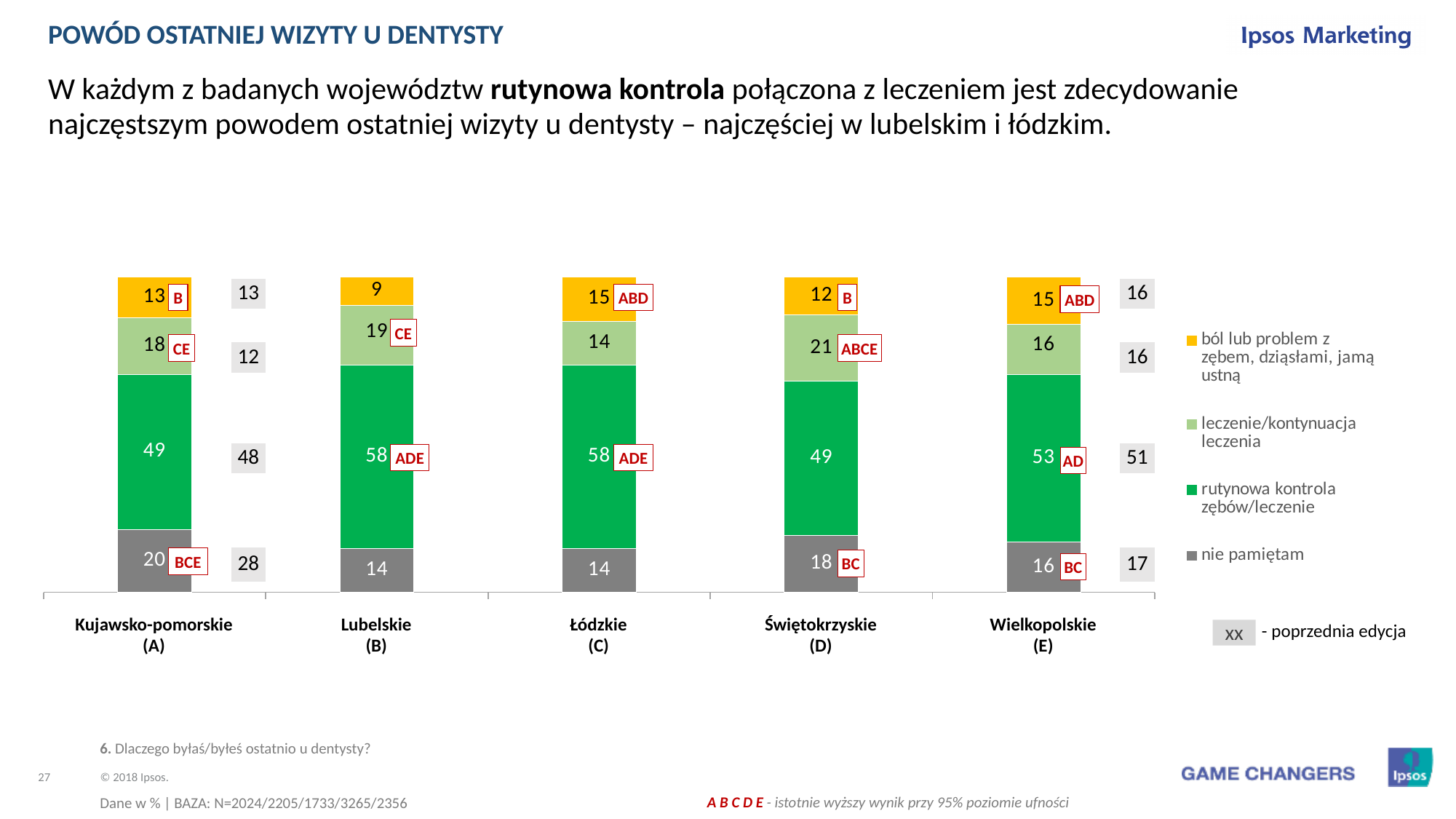
Which is larger: the 'nie pamiętam' value for Świętokrzyskie (D) or for Wielkopolskie (E)? Świętokrzyskie (D) How many series does the legend list? 4 What type of chart is shown on the slide? stacked bar chart Which voivodeship has the highest value for 'leczenie/kontynuacja leczenia'? Świętokrzyskie (D) What is the total of the stacked bar for Wielkopolskie (E)? 100 Which voivodeship has the lowest value for 'ból lub problem z zębem, dziąsłami, jamą ustną'? Lubelskie (B) What is the value for 'rutynowa kontrola zębów/leczenie' in Lubelskie (B)? 58 What is the value for 'ból lub problem z zębem, dziąsłami, jamą ustną' in Lubelskie (B)? 9 What is the value for 'leczenie/kontynuacja leczenia' in Świętokrzyskie (D)? 21 How many voivodeships (categories) are shown on the x axis? 5 What is the value for 'nie pamiętam' in Kujawsko-pomorskie (A)? 20 What is the difference between the 'rutynowa kontrola zębów/leczenie' values for Łódzkie (C) and Świętokrzyskie (D)? 9